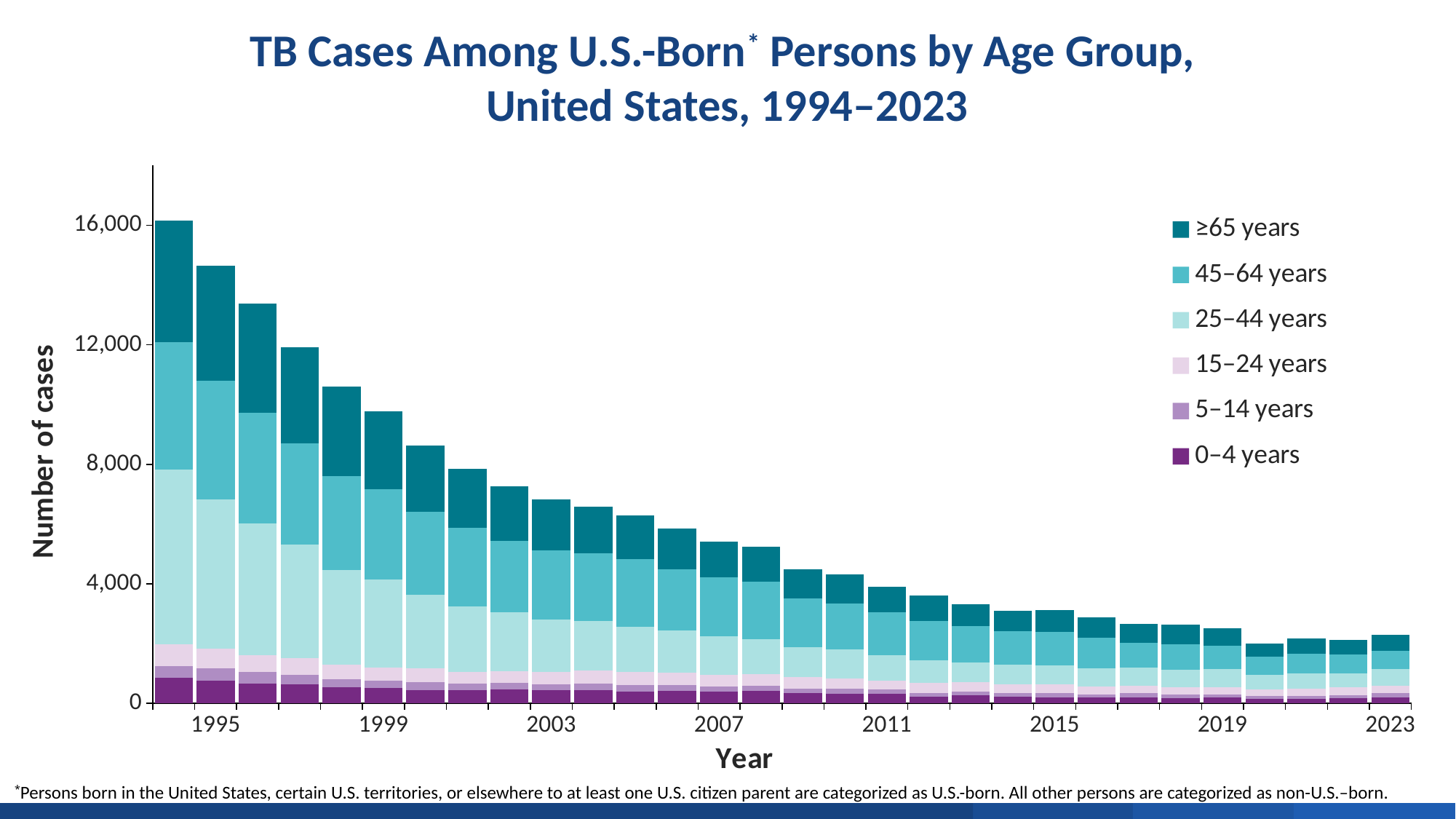
What kind of chart is shown on the slide? Stacked bar chart Is the total number of cases for 2007 greater or less than 4,000? greater How many years (bars) are plotted in the chart? 30 How many series does the legend list? 6 Is the total number of cases for 1999 greater or less than 8,000? greater Is the total number of cases for 2023 greater or less than 4,000? less Do the total TB cases among U.S.-born persons generally rise or fall from 1994 to 2023? Fall What is the label of the y-axis? Number of cases Which year has the highest total number of TB cases among U.S.-born persons? 1994 Which year has a larger total number of cases, 1999 or 2007? 1999 Which age group is listed first (at the top) in the legend? ≥65 years